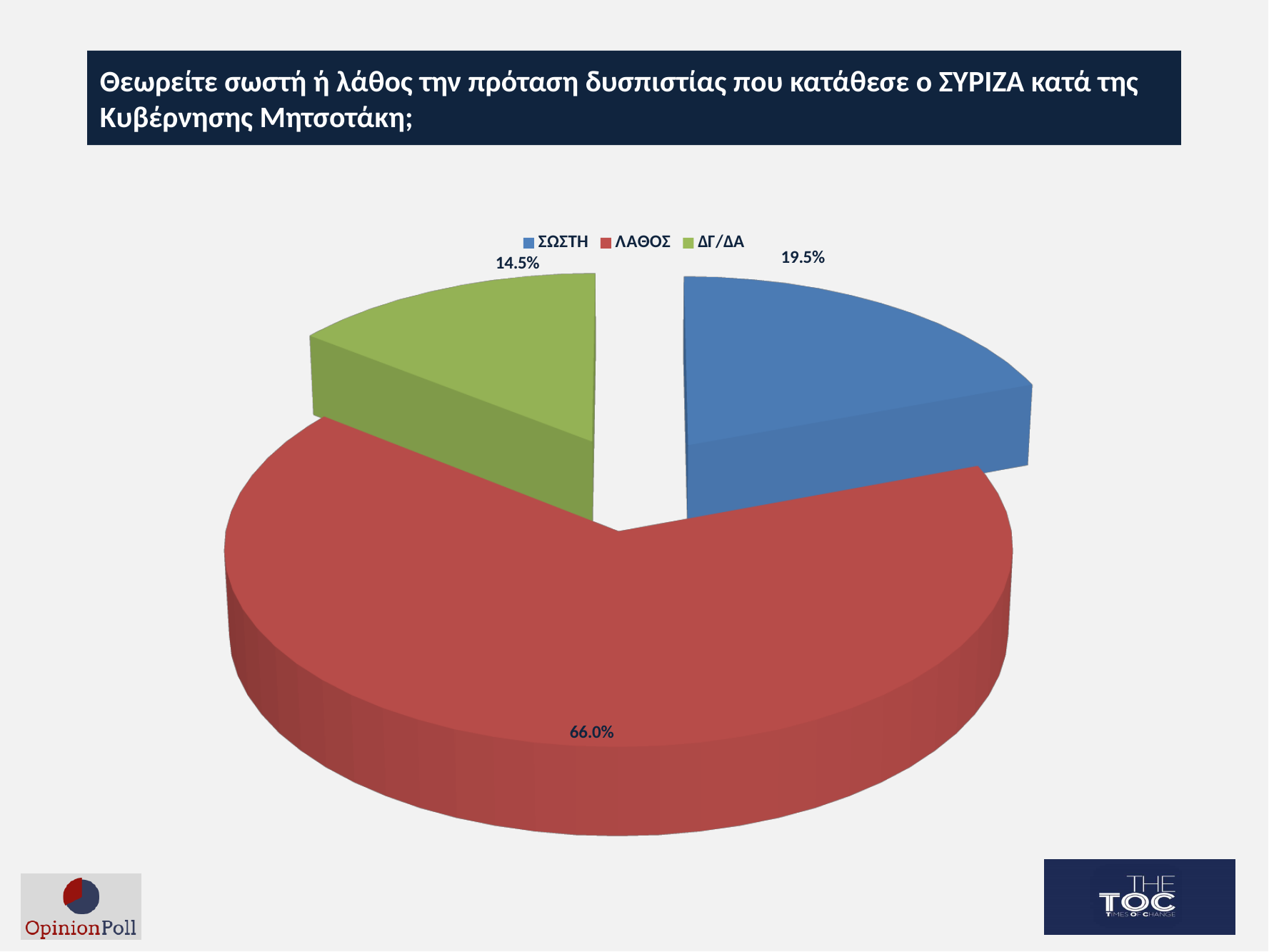
Which response has the largest share of the pie? ΛΑΘΟΣ Which response has the smallest share of the pie? ΔΓ/ΔΑ How many entries does the legend list? 3 What kind of chart is shown on the slide? Pie chart What colour is the ΛΑΘΟΣ slice? Red What is the difference in percentage points between ΛΑΘΟΣ and ΣΩΣΤΗ? 46.5 What percentage of respondents answered ΛΑΘΟΣ? 66.0% What percentage of respondents answered ΣΩΣΤΗ? 19.5% How many slices does the pie chart have? 3 What is the difference in percentage points between ΣΩΣΤΗ and ΔΓ/ΔΑ? 5.0 What percentage of respondents answered ΔΓ/ΔΑ? 14.5% Which is larger, the share for ΣΩΣΤΗ or the share for ΔΓ/ΔΑ? ΣΩΣΤΗ